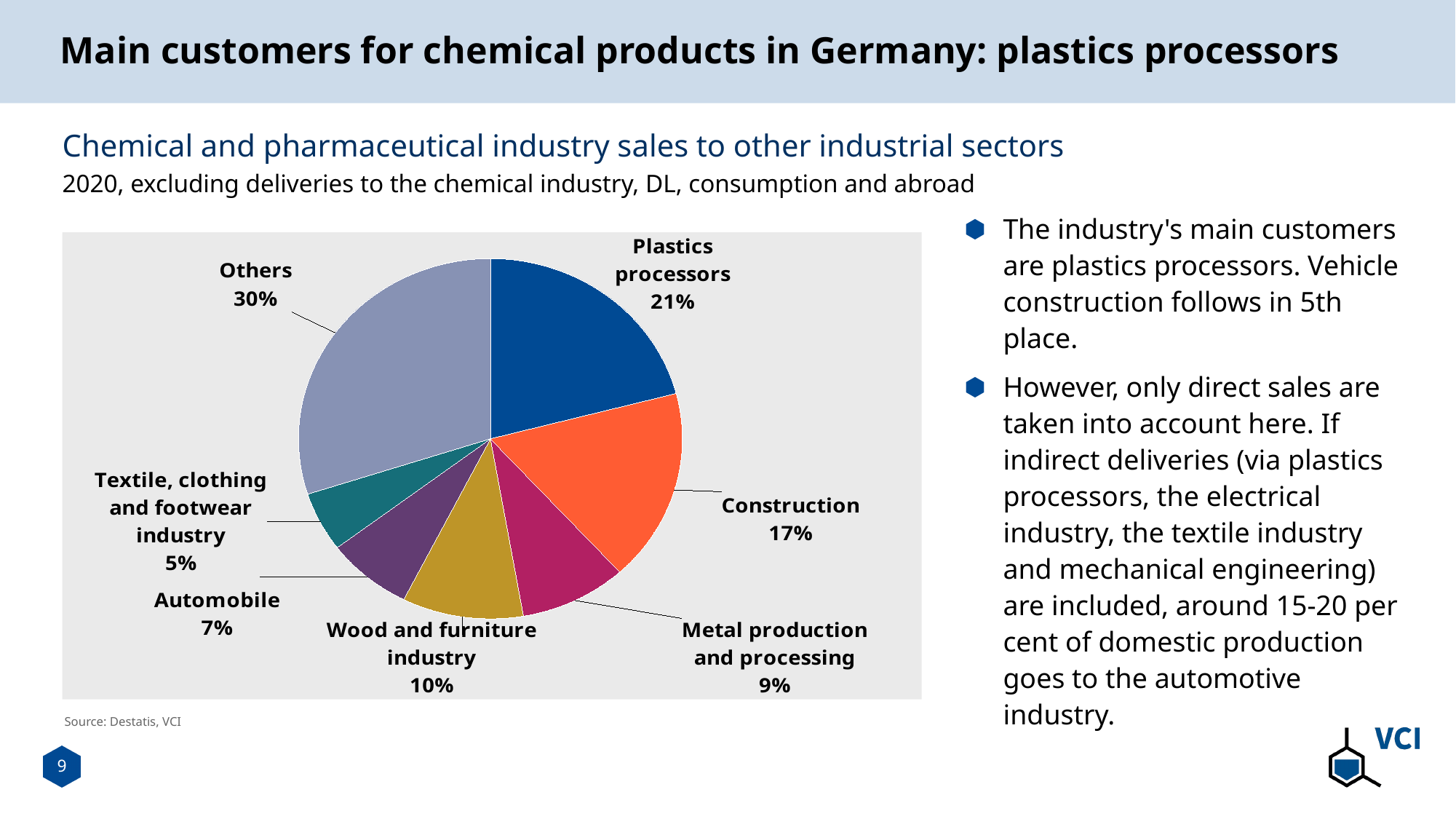
How many slices does the pie chart have? 7 What share of sales goes to the automobile sector? 7% Which is larger, the share for wood and furniture industry or for metal production and processing? Wood and furniture industry What share of sales goes to the textile, clothing and footwear industry? 5% What is the difference in percentage points between plastics processors and construction? 4 percentage points What share of sales goes to construction? 17% Which slice of the pie is the smallest? Textile, clothing and footwear industry What kind of chart is shown on the slide? Pie chart Which slice of the pie is the largest? Others Which named industrial sector (excluding Others) has the largest share? Plastics processors What is the source given for the chart? Destatis, VCI What share of sales goes to plastics processors? 21%